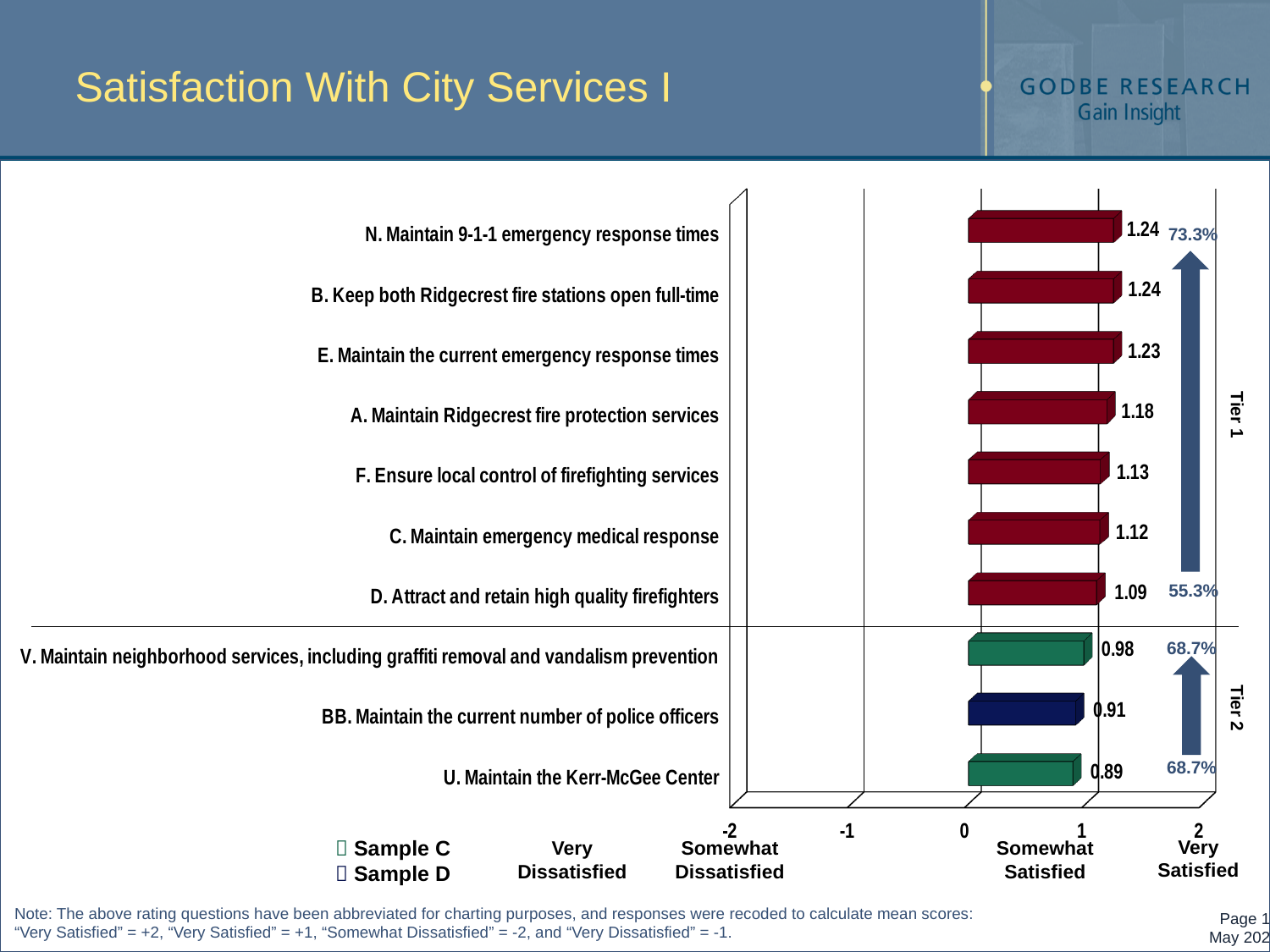
What is the difference between the mean score for "A. Maintain Ridgecrest fire protection services" and "D. Attract and retain high quality firefighters"? 0.09 Which service has the lowest mean score on the chart? U. Maintain the Kerr-McGee Center What is the mean score for "BB. Maintain the current number of police officers"? 0.91 What is the mean score for "U. Maintain the Kerr-McGee Center"? 0.89 Which has a higher mean score: "C. Maintain emergency medical response" or "V. Maintain neighborhood services, including graffiti removal and vandalism prevention"? C. Maintain emergency medical response What type of chart is shown on the slide? Bar chart What is the mean score for "E. Maintain the current emergency response times"? 1.23 Is the mean score for "D. Attract and retain high quality firefighters" greater or less than 1? greater How many entries does the legend list? 2 How many services are plotted on the chart? 10 What is the mean score for "F. Ensure local control of firefighting services"? 1.13 What is the difference between the mean score for "N. Maintain 9-1-1 emergency response times" and "U. Maintain the Kerr-McGee Center"? 0.35